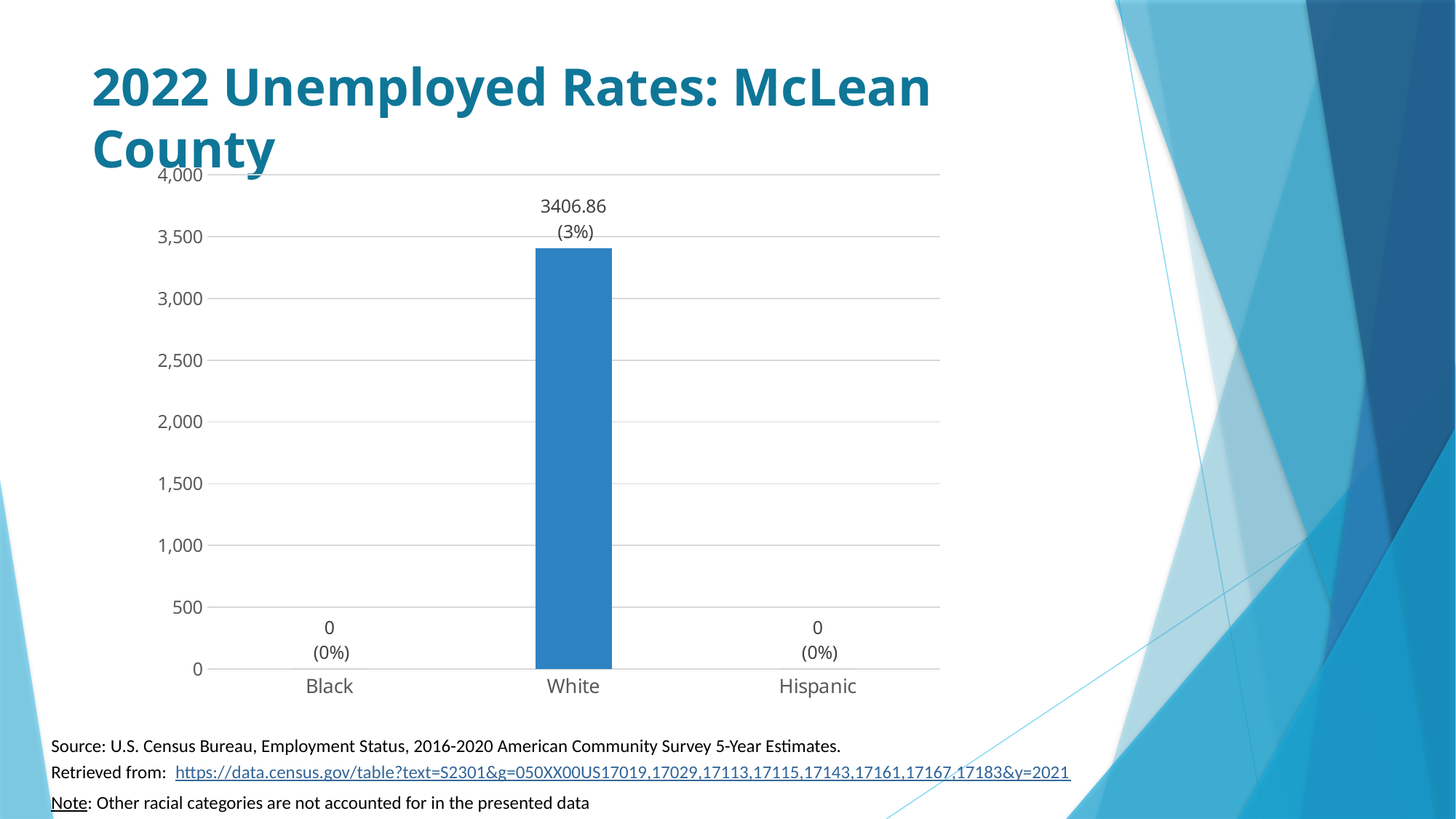
What is the value shown for Hispanic? 0 Which is larger, the value for White or the value for Hispanic? White What is the value shown for Black? 0 Is the value for White greater or less than 3,000? greater What percentage is shown in the data label for White? 3% What is the difference between the values for White and Black? 3406.86 What is the title of the slide? 2022 Unemployed Rates: McLean County How many categories are shown on the x axis? 3 What is the value shown for White? 3406.86 What is the highest value labelled on the y axis? 4,000 Which category has the highest value? White What kind of chart is shown on the slide? bar chart